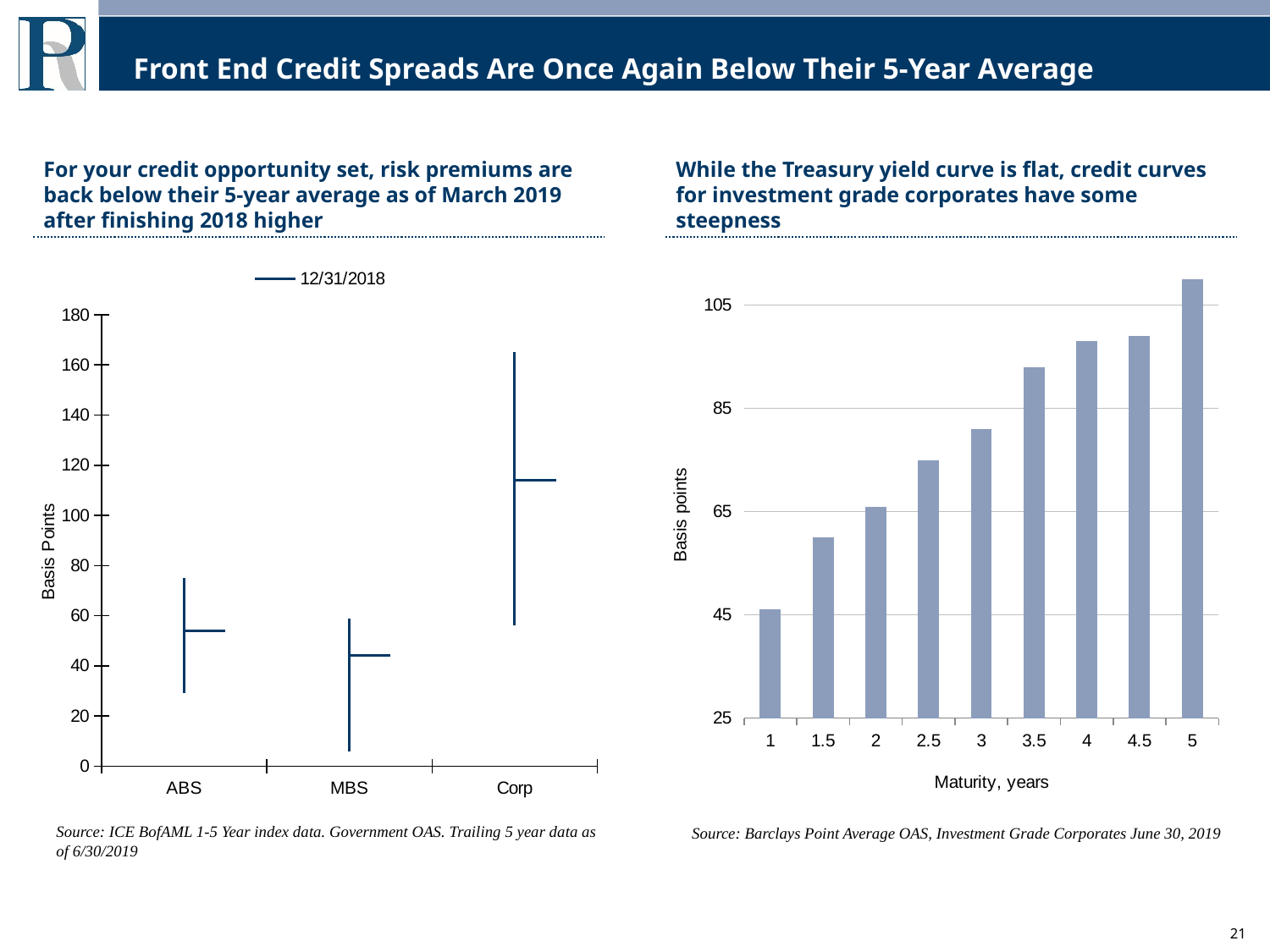
In the right-hand chart, is the value for maturity 3 greater or less than 65? greater In the right-hand chart, which maturity has the lowest basis points value? 1 In the left-hand chart, what entry does the legend list? 12/31/2018 What kind of chart is the right-hand chart (Basis points vs Maturity, years)? bar chart In the left-hand chart, how many categories are shown on the x axis? 3 In the right-hand chart, which has the larger value, maturity 2 or maturity 3? maturity 3 In the left-hand chart, is the 12/31/2018 value for Corp greater or less than 100? greater In the right-hand chart, which maturity has the highest basis points value? 5 In the right-hand chart, is the value for maturity 1 greater or less than 65? less In the right-hand chart, do the basis points values rise or fall as maturity increases from 1 to 5 years? rise In the right-hand chart, how many maturity categories are shown on the x axis? 9